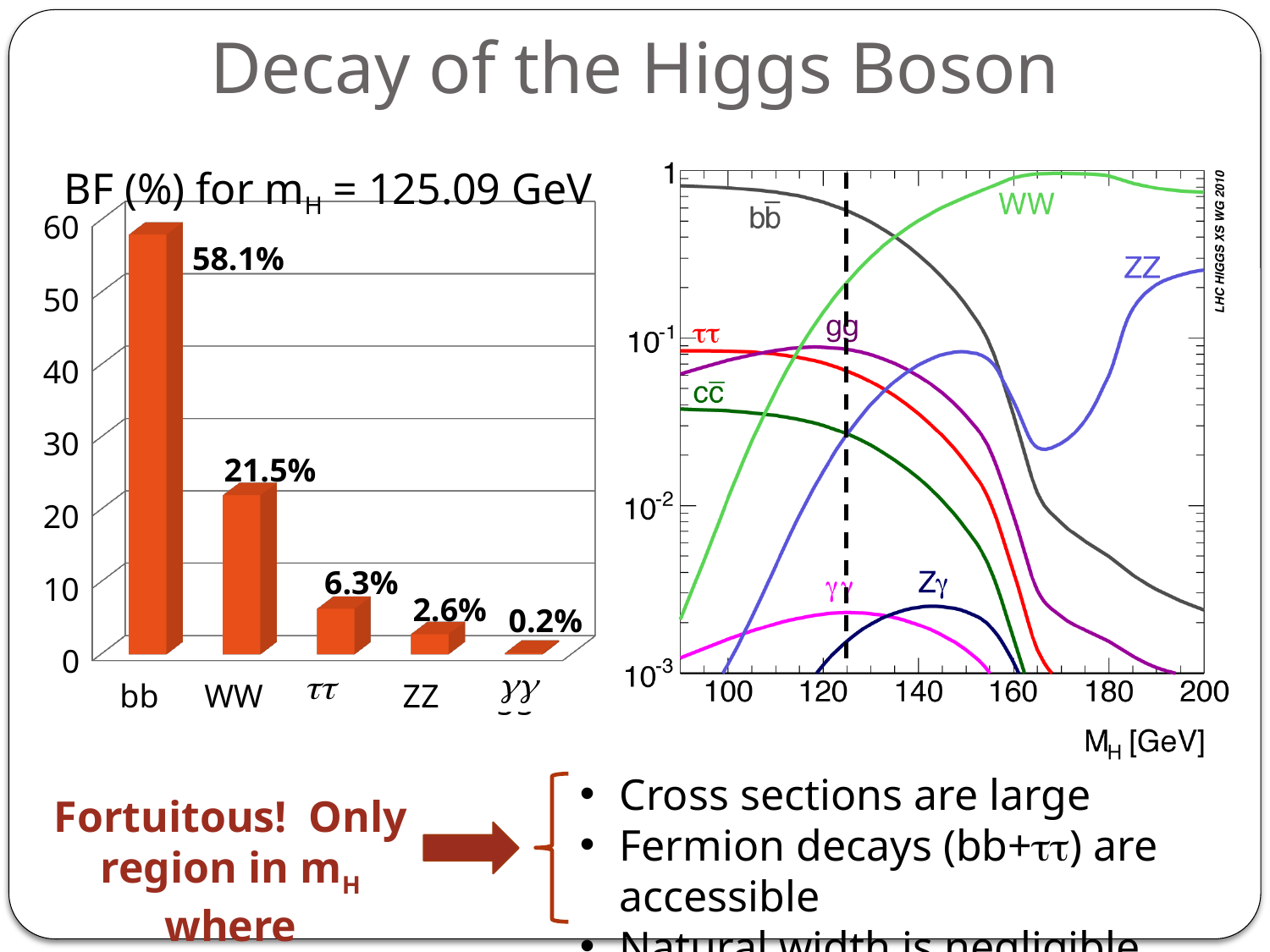
In the line chart on the right, what is the label of the x axis? MH [GeV] What kind of chart is the chart on the left of the slide? bar chart In the line chart on the right, does the WW curve rise or fall as MH increases from 100 to 160 GeV? rise In the bar chart on the left, what is the difference between the branching fractions for bb and WW? 36.6% In the bar chart on the left, which decay mode has the lowest branching fraction? γγ In the bar chart on the left, what is the branching fraction for ZZ? 2.6% In the bar chart on the left, how many decay modes are shown? 5 In the bar chart on the left, what is the branching fraction for WW? 21.5% What is the title of the bar chart on the left? BF (%) for mH = 125.09 GeV In the bar chart on the left, which is larger, the branching fraction for ττ or for ZZ? ττ In the bar chart on the left, what is the branching fraction for bb? 58.1% In the bar chart on the left, which decay mode has the highest branching fraction? bb